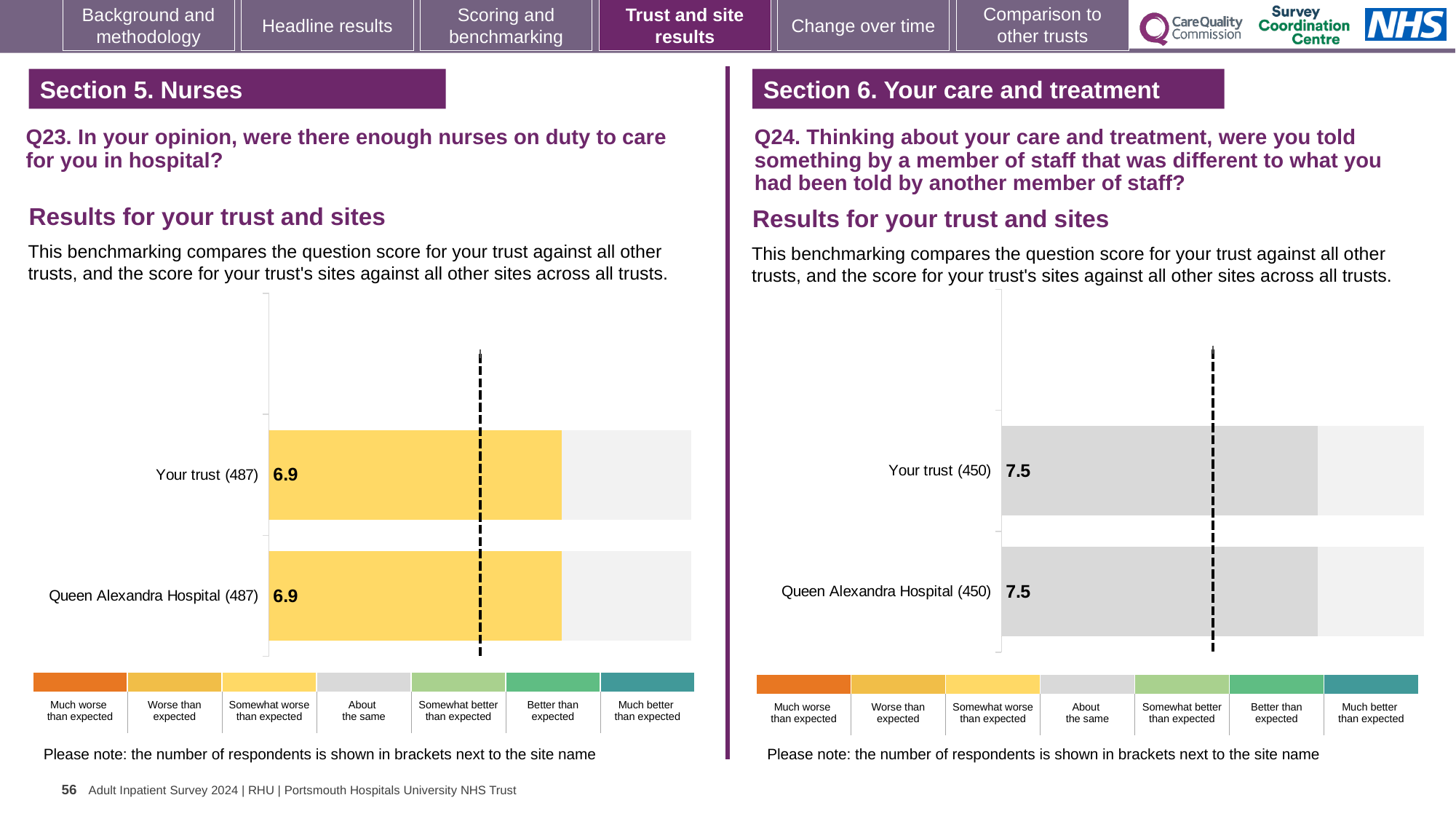
On the Q23 chart (left), how many respondents are shown in brackets for Your trust? 487 How many bars are plotted on the Q24 chart (right)? 2 On the Q24 chart (right), what is the score for Your trust? 7.5 How many bars are plotted on the Q23 chart (left)? 2 On the Q23 chart (left), what is the score for Your trust? 6.9 On the Q24 chart (right), what is the score for Queen Alexandra Hospital? 7.5 On the Q24 chart (right), how many respondents are shown in brackets for Queen Alexandra Hospital? 450 According to the colour key, which benchmark category do the bars on the Q24 chart (right) fall into? About the same On the Q24 chart (right), what is the difference between the score for Your trust and the score for Queen Alexandra Hospital? 0.0 On the Q23 chart (left), what is the difference between the score for Your trust and the score for Queen Alexandra Hospital? 0.0 On the Q23 chart (left), what is the score for Queen Alexandra Hospital? 6.9 What kind of chart is the Q23 chart (left)? Bar chart